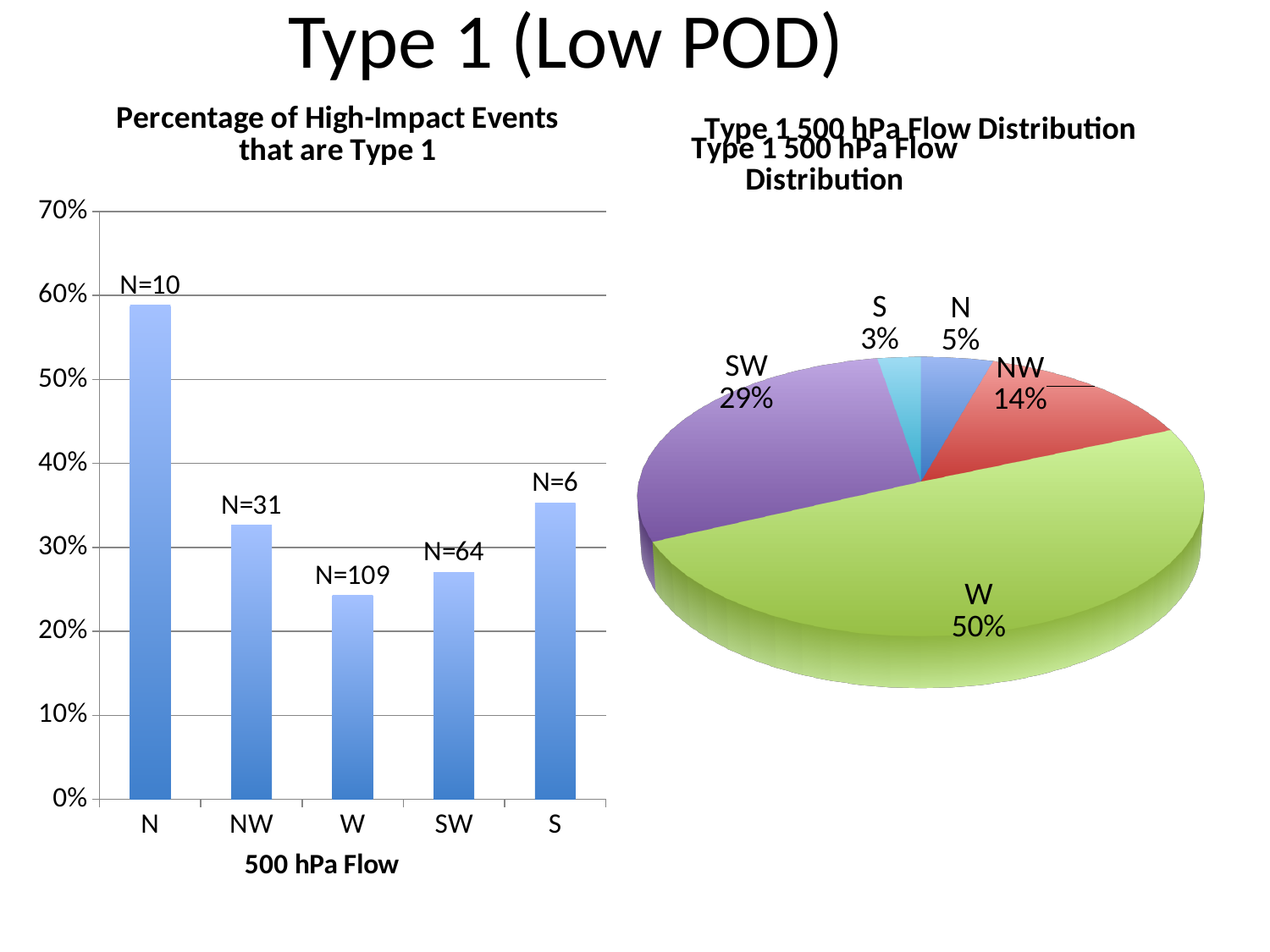
In the 'Percentage of High-Impact Events that are Type 1' chart, how many 500 hPa flow categories are shown on the x axis? 5 What kind of chart is the 'Type 1 500 hPa Flow Distribution' chart? pie chart In the 'Percentage of High-Impact Events that are Type 1' chart, which 500 hPa flow category has the highest percentage? N In the 'Percentage of High-Impact Events that are Type 1' chart, which 500 hPa flow category has the lowest percentage? W In the 'Type 1 500 hPa Flow Distribution' pie chart, which category has the smallest slice? S In the 'Percentage of High-Impact Events that are Type 1' chart, is the value for N greater or less than 50%? greater In the 'Type 1 500 hPa Flow Distribution' pie chart, what share does W have? 50% In the 'Type 1 500 hPa Flow Distribution' pie chart, what is the difference between the NW share and the N share? 9% In the 'Percentage of High-Impact Events that are Type 1' chart, is the value for W greater or less than 30%? less In the 'Type 1 500 hPa Flow Distribution' pie chart, what share does SW have? 29% What kind of chart is the 'Percentage of High-Impact Events that are Type 1' chart? bar chart In the 'Percentage of High-Impact Events that are Type 1' chart, what sample size label is shown above the W bar? N=109